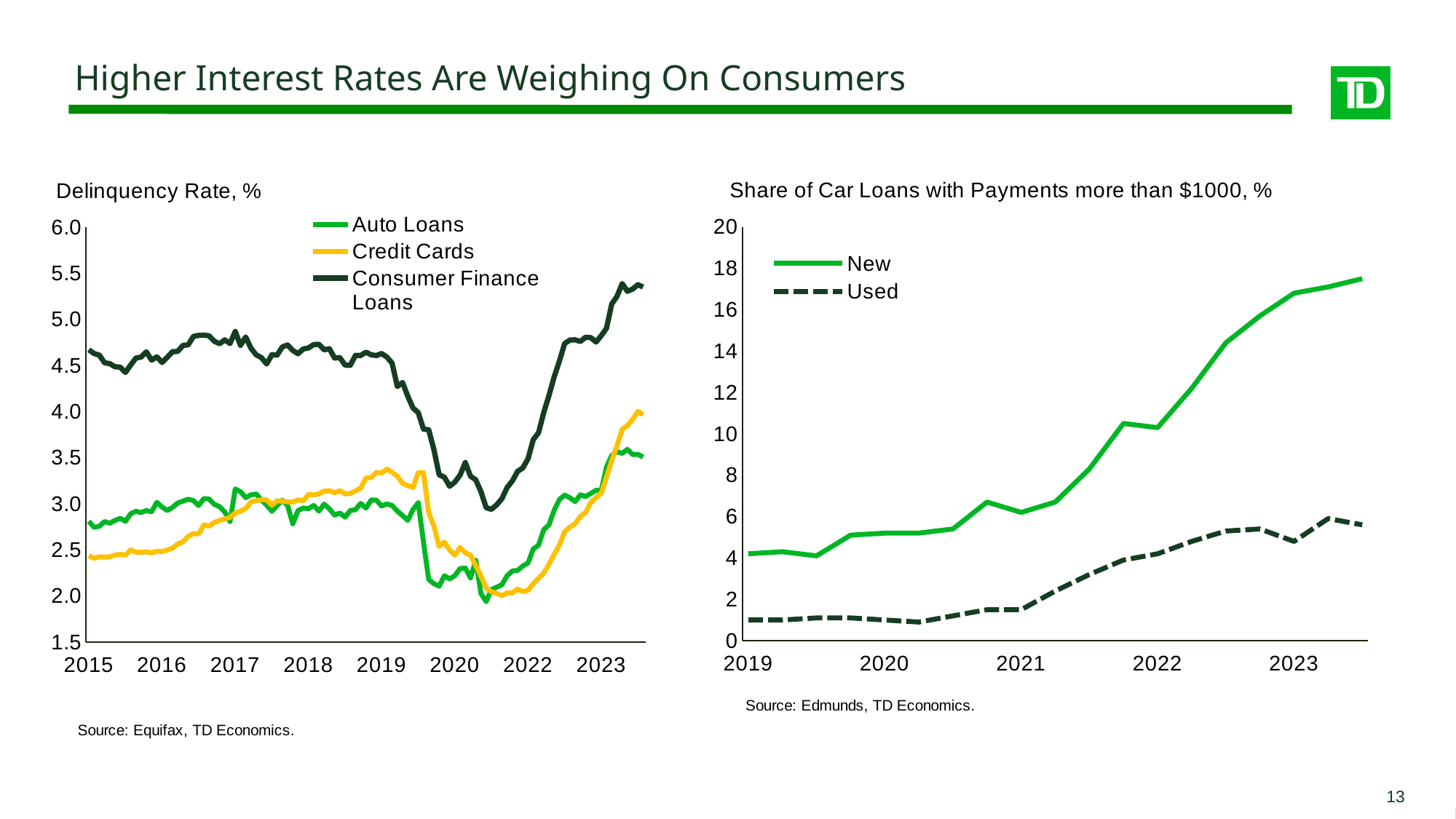
In the Share of Car Loans with Payments more than $1000 chart, which series is drawn with a dashed line? Used In the Share of Car Loans with Payments more than $1000 chart, does the New series rise or fall from 2019 to 2023? Rise In the Delinquency Rate chart, is the value for Credit Cards at the start of 2015 greater or less than 3.0? less In the Share of Car Loans with Payments more than $1000 chart, is the value for New in 2023 greater or less than 14? greater How many series does the legend of the Delinquency Rate chart list? 3 In the Delinquency Rate chart, which series has the highest value at the end of 2023? Consumer Finance Loans How many series does the legend of the Share of Car Loans with Payments more than $1000 chart list? 2 What kind of chart is the Delinquency Rate chart on the left? Line chart In the Delinquency Rate chart, is the value for Consumer Finance Loans at the start of 2015 greater or less than 4.0? greater In the Delinquency Rate chart, which series has the lowest value at the end of 2023? Auto Loans In the Share of Car Loans with Payments more than $1000 chart, which series is higher at the end of 2023, New or Used? New